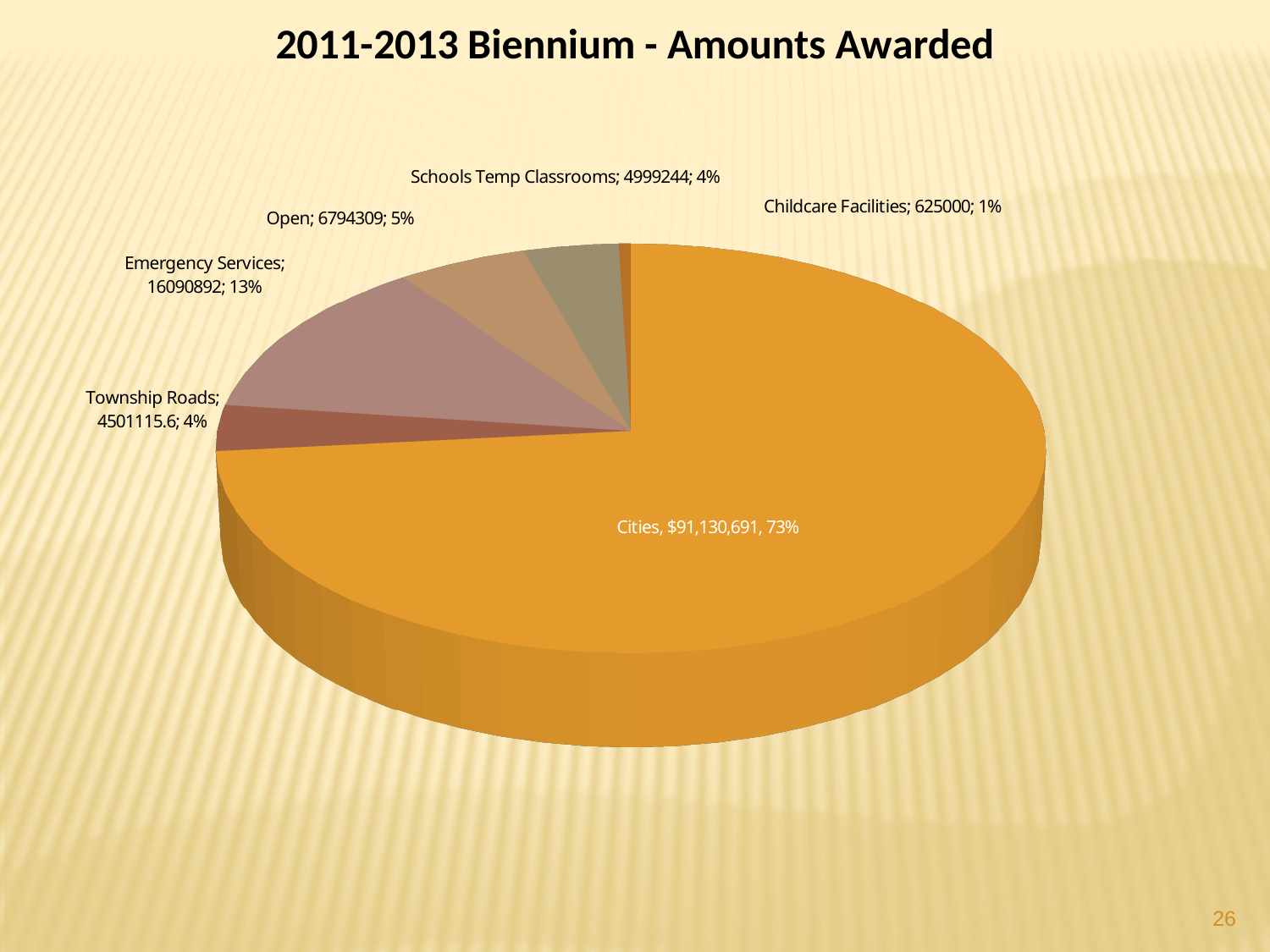
What kind of chart is shown on the slide? Pie chart What is the difference between the amounts for Emergency Services and Open? 9296583 How many slices does the pie chart have? 6 What amount is shown for Emergency Services? 16090892 What amount is shown for Cities? $91,130,691 What share of the pie does Cities represent? 73% Which category has the largest slice? Cities What is the title of the chart? 2011-2013 Biennium - Amounts Awarded What amount is shown for Township Roads? 4501115.6 Which is larger, the amount for Emergency Services or the amount for Open? Emergency Services What share of the pie does Emergency Services represent? 13% Which category has the smallest slice? Childcare Facilities